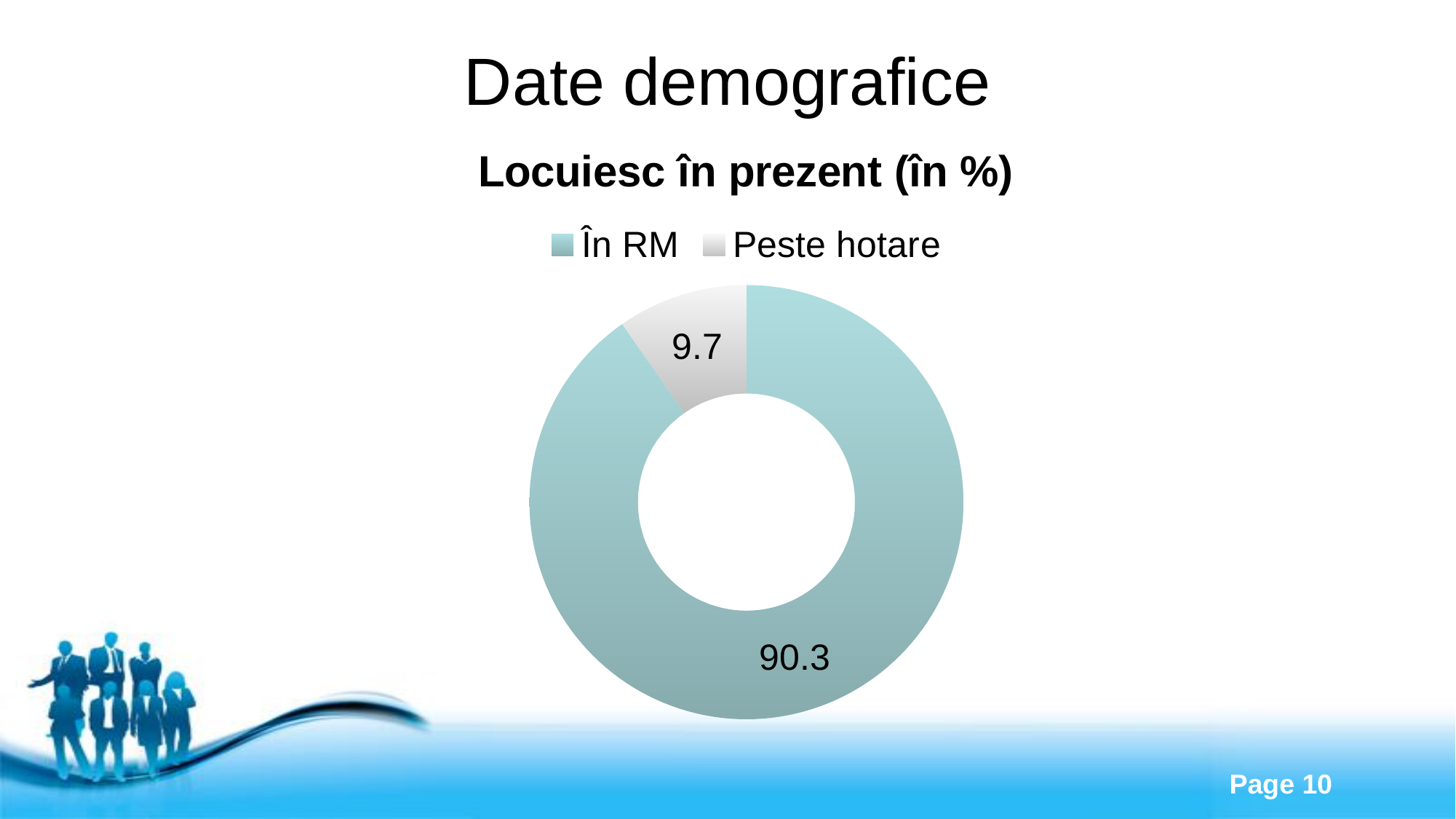
How many categories does the chart show? 2 What value is shown for Peste hotare? 9.7 Which legend entry is shown in grey? Peste hotare Which category has the largest share of the chart? În RM Which category has the smallest share of the chart? Peste hotare How many entries does the legend list? 2 What value is shown for În RM? 90.3 What is the total of the two values shown on the chart? 100 What kind of chart is shown on the slide? Doughnut (pie) chart What is the difference between the values for În RM and Peste hotare? 80.6 Which is larger, the value for În RM or the value for Peste hotare? În RM What is the title of the chart? Locuiesc în prezent (în %)